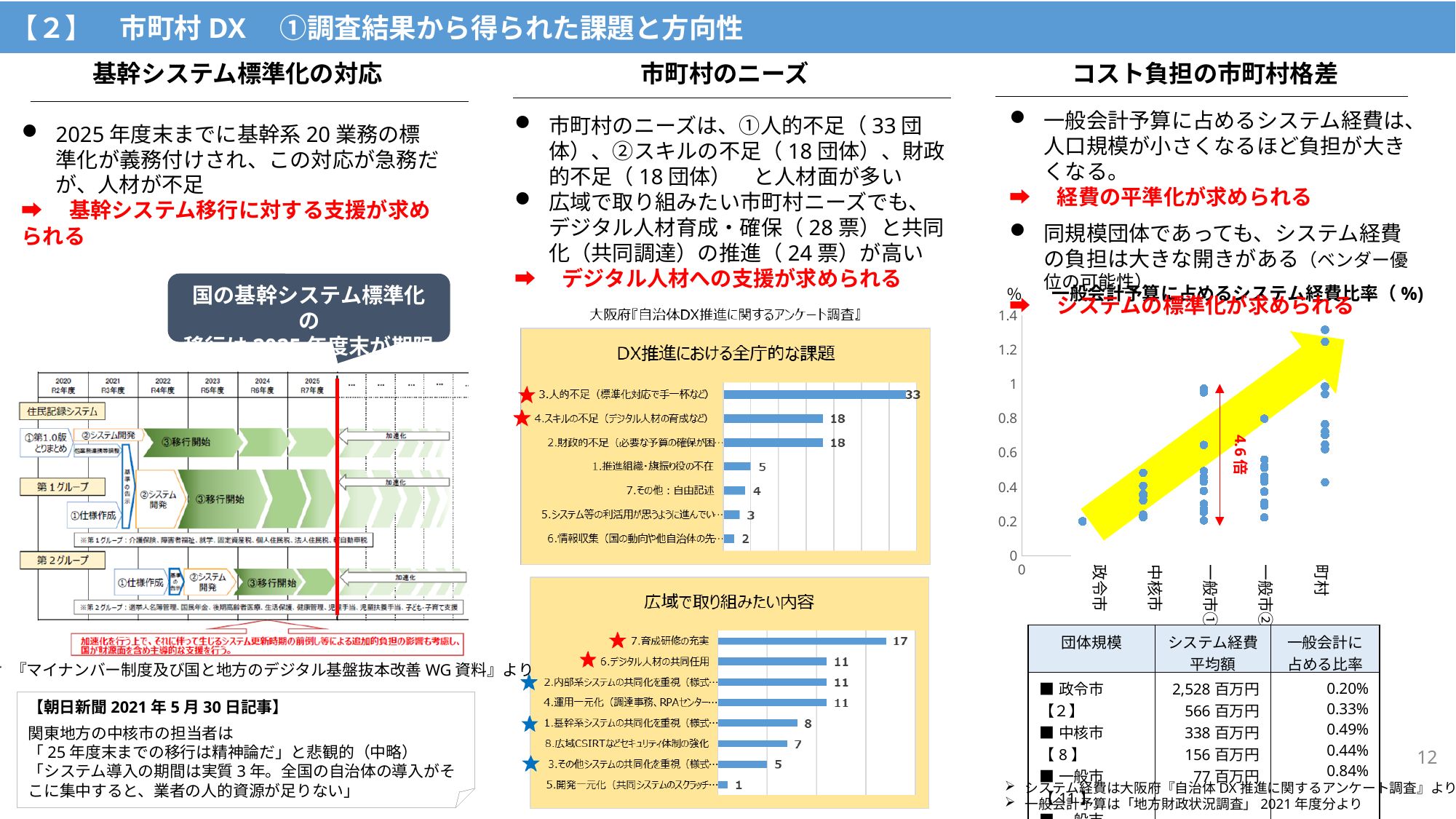
In the chart titled 「DX推進における全庁的な課題」, what is the value for 「3.人的不足」? 33 In the chart titled 「広域で取り組みたい内容」, which category has the lowest value? 5.開発一元化 In the chart titled 「DX推進における全庁的な課題」, which category has the lowest value? 6.情報収集 In the chart titled 「広域で取り組みたい内容」, what is the value for 「7.育成研修の充実」? 17 In the scatter chart titled 「一般会計予算に占めるシステム経費比率（%）」, is the value for 政令市 greater or less than 0.4? less What kind of chart is the chart titled 「DX推進における全庁的な課題」? Bar chart In the chart titled 「DX推進における全庁的な課題」, how many categories are plotted? 7 In the chart titled 「DX推進における全庁的な課題」, which category has the highest value? 3.人的不足 In the chart titled 「広域で取り組みたい内容」, what is the value for 「8.広域CSIRTなどセキュリティ体制の強化」? 7 In the chart titled 「広域で取り組みたい内容」, how many categories are plotted? 8 In the chart titled 「DX推進における全庁的な課題」, what is the difference between the values for 「3.人的不足」 and 「4.スキルの不足」? 15 In the chart titled 「広域で取り組みたい内容」, which is larger, the value for 「1.基幹系システムの共同化を重視」 or the value for 「3.その他システムの共同化を重視」? 1.基幹系システムの共同化を重視